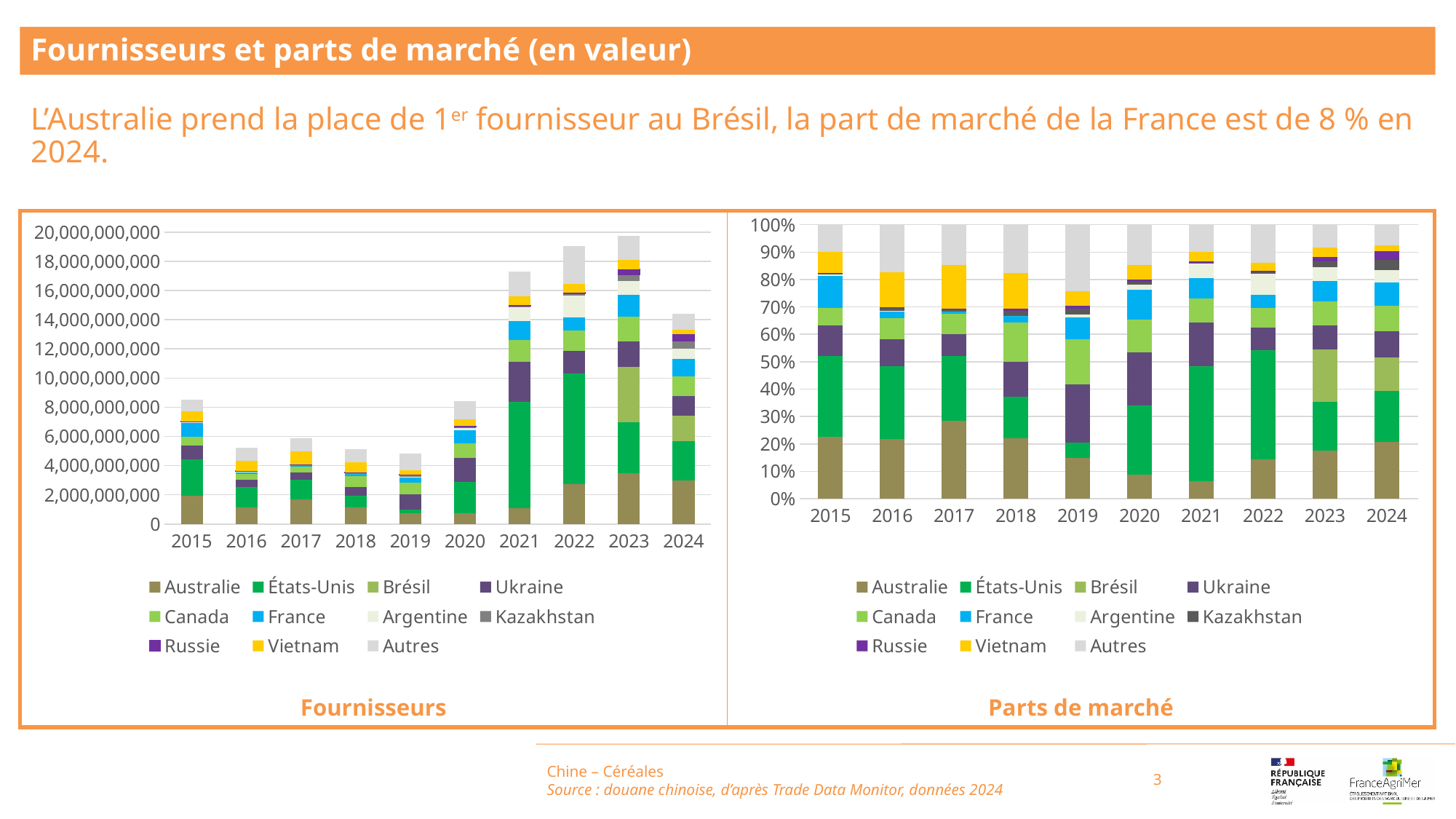
In the 'Fournisseurs' chart, which year has the tallest stacked bar? 2023 In the 'Fournisseurs' chart, is the total for 2019 greater or less than 6,000,000,000? less In the 'Fournisseurs' chart, do the total bar heights rise or fall from 2019 to 2023? rise In the 'Fournisseurs' chart, which year has the shortest stacked bar? 2019 In the 'Fournisseurs' chart, which year has the larger total bar, 2021 or 2024? 2021 What is the title of the chart on the right of the slide? Parts de marché What kind of chart is the 'Fournisseurs' chart on the left? Stacked bar chart In the 'Fournisseurs' chart, how many years are shown on the x axis? 10 How many series does the legend of the 'Parts de marché' chart list? 11 In the 'Parts de marché' chart, is the share for Australie in 2017 greater or less than 20%? greater In the 'Fournisseurs' chart, is the total for 2023 greater or less than 18,000,000,000? greater